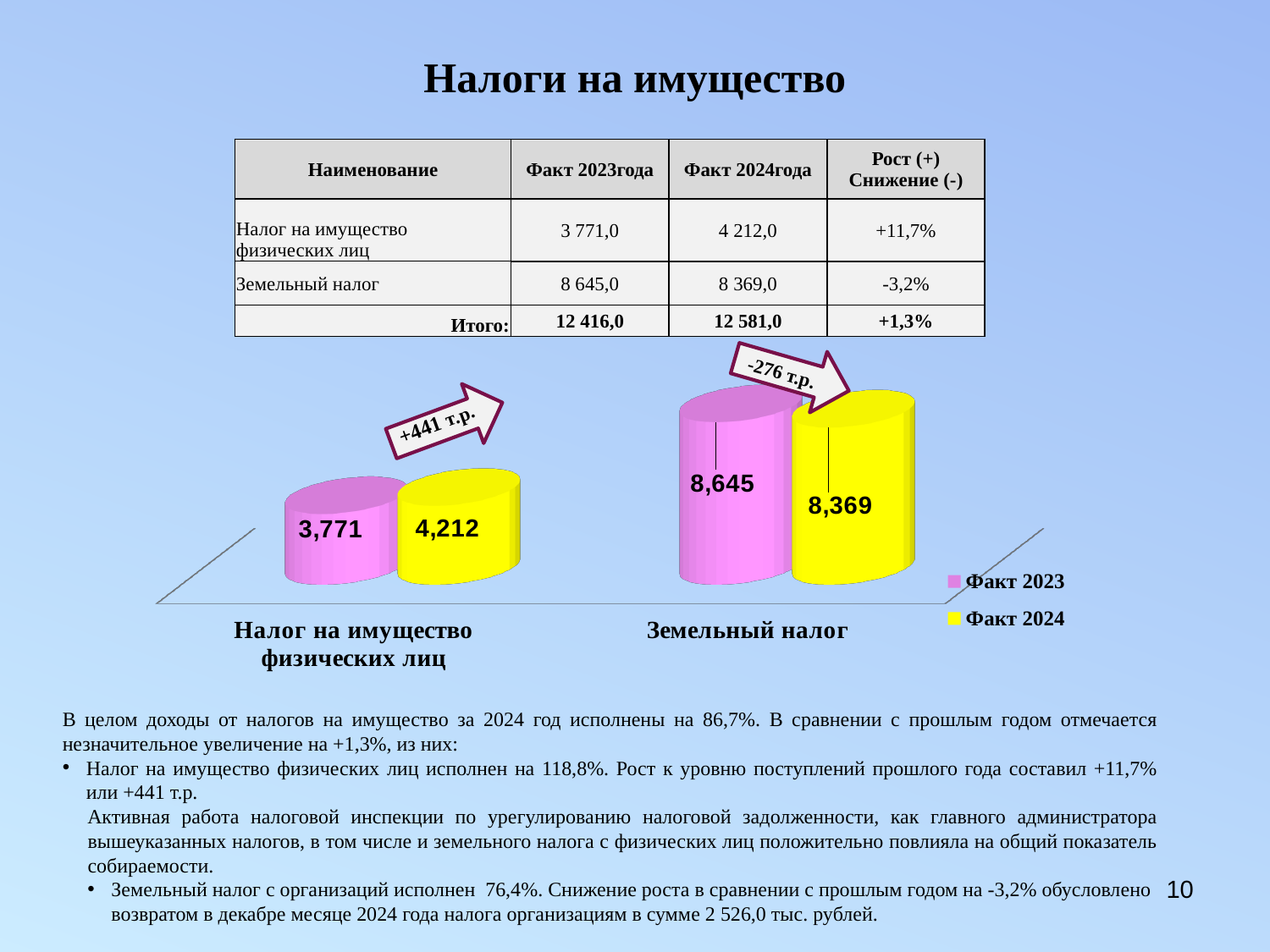
Which category has the lowest Факт 2024 value in the chart? Налог на имущество физических лиц How many series does the chart legend list? 2 What is the value for Факт 2024 for Земельный налог in the chart? 8,369 What is the value for Факт 2024 for Налог на имущество физических лиц in the chart? 4,212 How many categories are shown on the x axis of the chart? 2 Which category has the highest Факт 2023 value in the chart? Земельный налог What is the difference between the Факт 2023 and Факт 2024 values for Земельный налог in the chart? 276 What is the value for Факт 2023 for Земельный налог in the chart? 8,645 What kind of chart is shown on the slide? Bar chart What is the value for Факт 2023 for Налог на имущество физических лиц in the chart? 3,771 What is the difference between the Факт 2024 and Факт 2023 values for Налог на имущество физических лиц in the chart? 441 For Земельный налог, which is larger in the chart: Факт 2023 or Факт 2024? Факт 2023